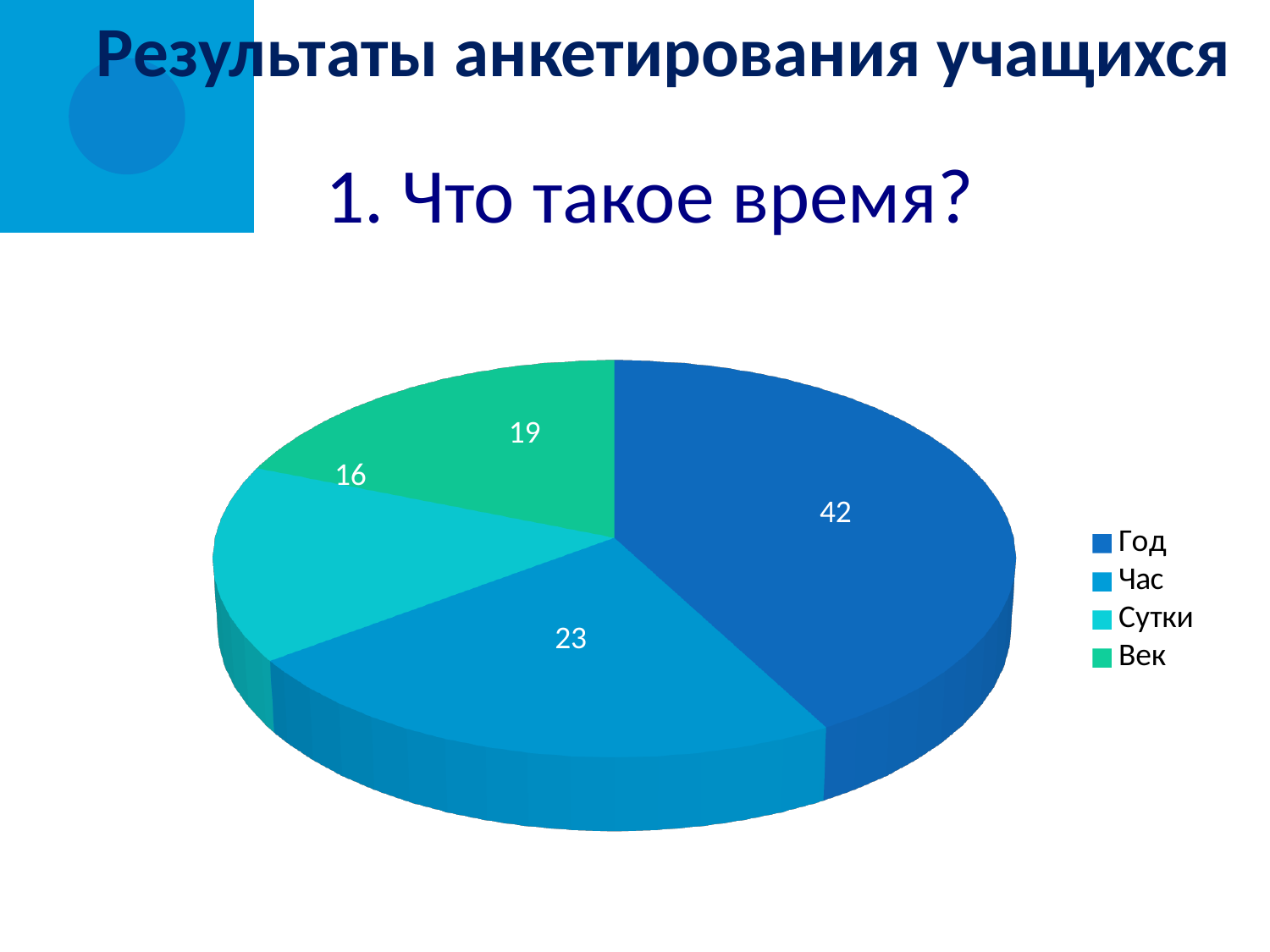
What share of the pie does the Год slice represent? 42% Which is larger, the value for Век or the value for Сутки? Век What is the value for Сутки in the pie chart? 16 What is the question shown as the chart's heading? 1. Что такое время? What is the value for Час in the pie chart? 23 Which category has the largest slice of the pie? Год What is the value for Век in the pie chart? 19 What is the value for Год in the pie chart? 42 Which category has the smallest slice of the pie? Сутки What is the difference between the values for Год and Час? 19 How many categories does the pie chart have? 4 What type of chart is shown on the slide? Pie chart